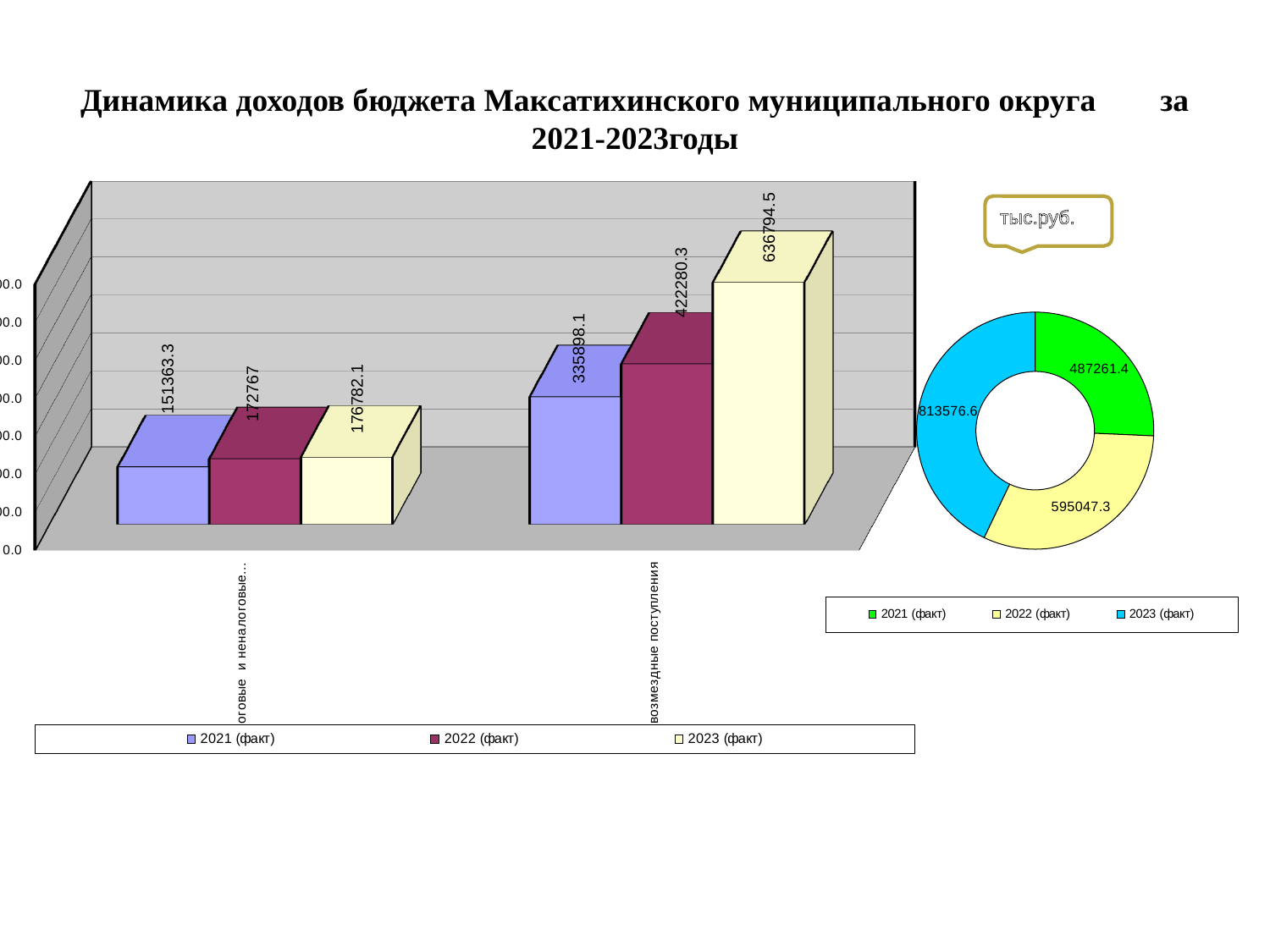
How many series does the legend of the bar chart list? 3 In the bar chart, which series has the highest value in the безвозмездные поступления category? 2023 (факт) In the bar chart, what is the value for 2021 (факт) in the left category group (налоговые и неналоговые...)? 151363.3 What kind of chart is the chart on the left of the slide? Bar chart In the bar chart, what is the value for 2022 (факт) in the безвозмездные поступления category? 422280.3 In the doughnut chart, what is the value for 2023 (факт)? 813576.6 In the doughnut chart, which year has the smallest value? 2021 (факт) In the doughnut chart, what is the difference between the 2023 (факт) and 2021 (факт) values? 326315.2 In the bar chart, what is the difference between the 2023 (факт) and 2021 (факт) values for безвозмездные поступления? 300896.4 In the bar chart, what is the value for 2023 (факт) in the безвозмездные поступления category? 636794.5 In the bar chart, which is larger in the left category group: the 2022 (факт) value or the 2023 (факт) value? 2023 (факт) How many categories are shown on the x axis of the bar chart? 2